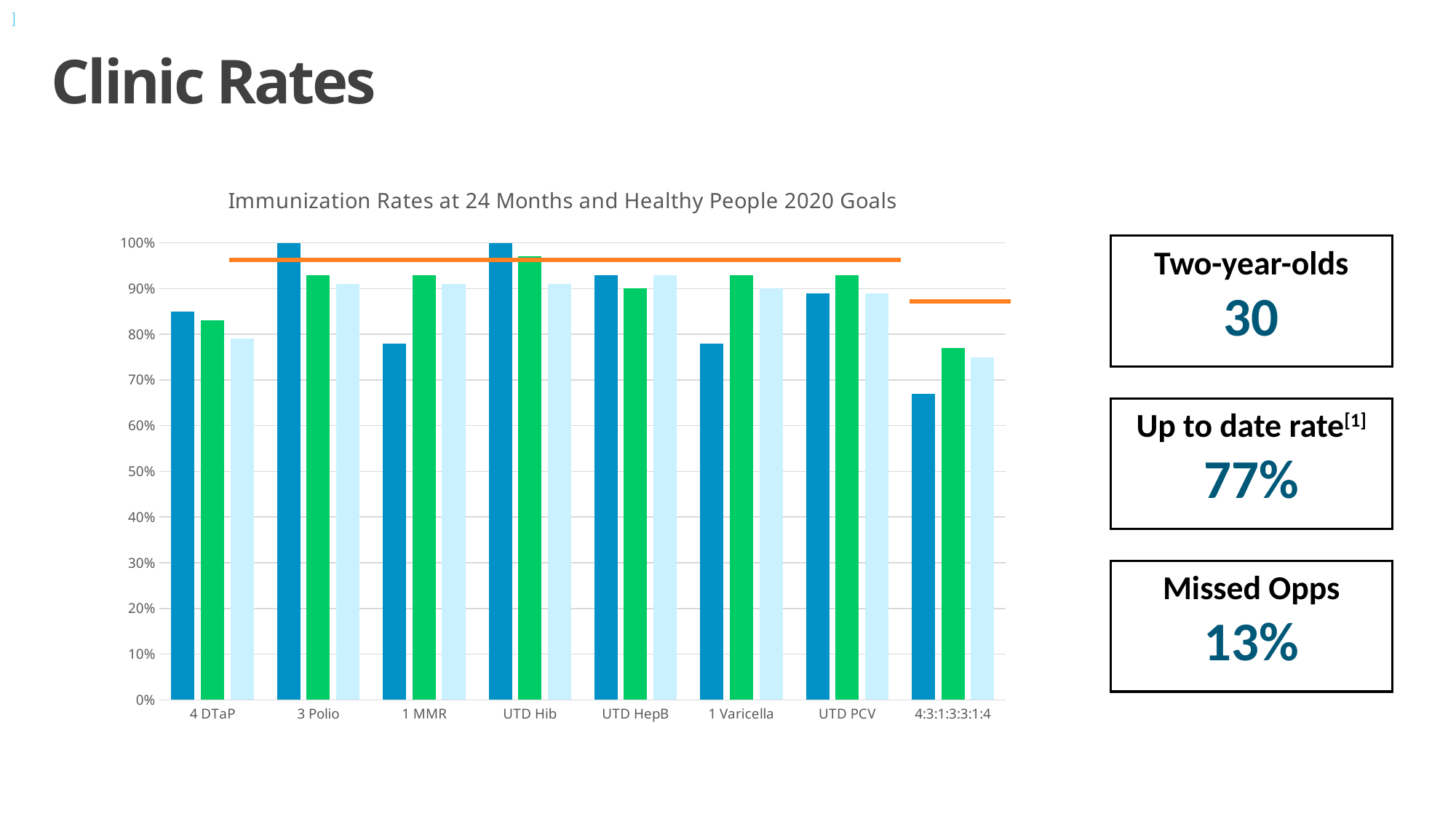
Is the dark blue bar for 4 DTaP greater or less than 80%? greater Is the dark blue bar for 4:3:1:3:3:1:4 greater or less than 70%? less What is the highest value shown on the y axis of the chart? 100% What kind of chart is shown on the slide? bar chart Which has the larger dark blue bar, 4 DTaP or 1 MMR? 4 DTaP What is the value of the dark blue bar for UTD Hib? 100% What is the value of the dark blue bar for 3 Polio? 100% Is the dark blue bar for UTD HepB greater or less than 90%? greater What is the title of the chart? Immunization Rates at 24 Months and Healthy People 2020 Goals Which category has the lowest dark blue bar? 4:3:1:3:3:1:4 How many categories are shown on the x axis of the chart? 8